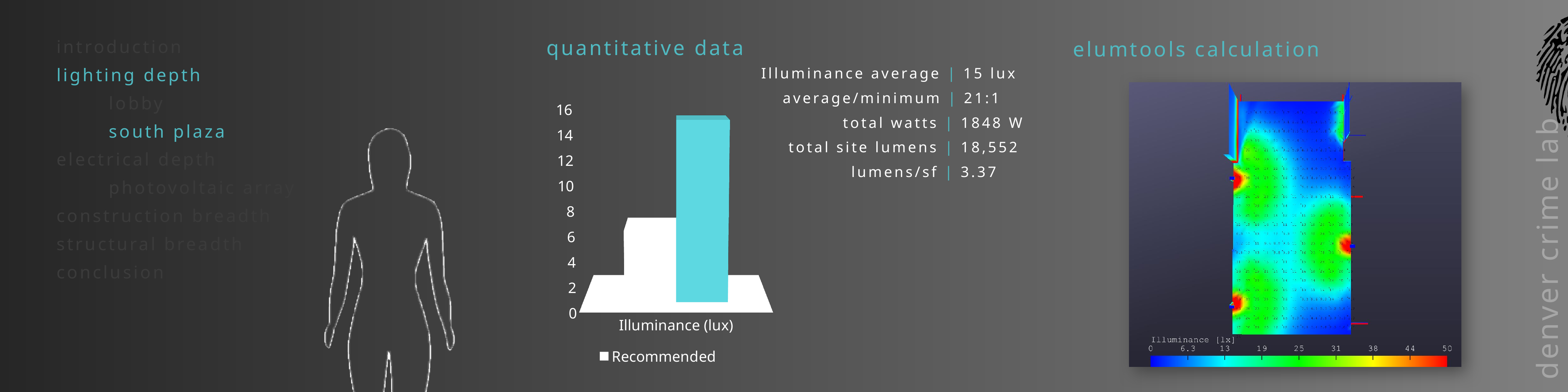
What colour is the Recommended bar in the bar chart? white Is the value of the Recommended bar in the bar chart greater or less than 4? greater Is the value of the cyan bar in the bar chart greater or less than 12? greater Is the value of the Recommended bar in the bar chart greater or less than 10? less How many series does the legend of the bar chart list? 1 In the bar chart, which bar is taller, the white Recommended bar or the cyan bar? the cyan bar What kind of chart is shown under the heading "quantitative data"? bar chart What is the name of the series listed in the legend of the bar chart? Recommended How many categories are shown on the x axis of the bar chart? 1